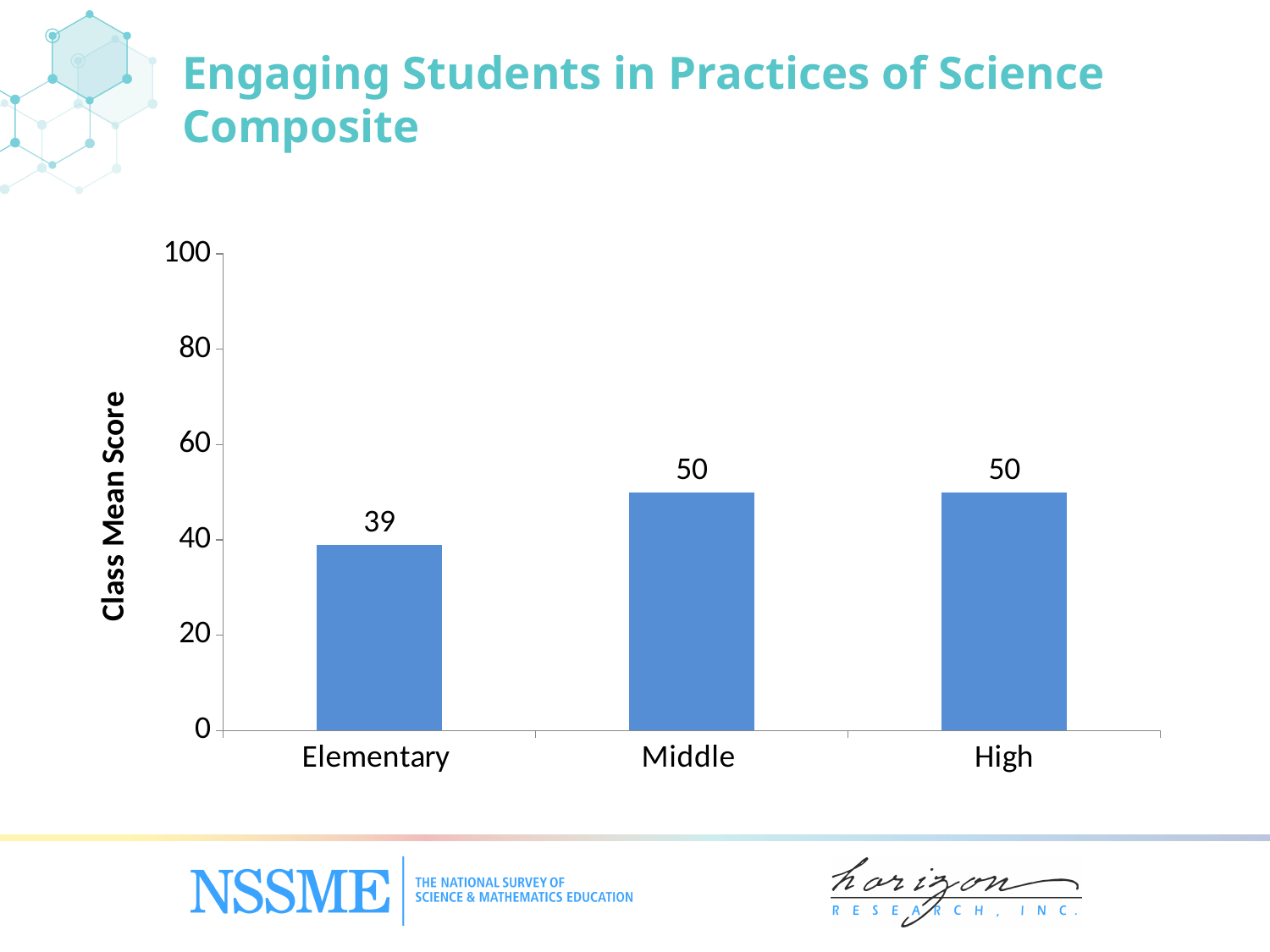
What is the label of the vertical axis? Class Mean Score Which has a higher class mean score, Elementary or High? High What is the class mean score for Elementary? 39 What is the difference between the class mean scores for Middle and Elementary? 11 What is the class mean score for Middle? 50 What is the maximum value shown on the vertical axis? 100 What kind of chart is shown on the slide? bar chart What is the class mean score for High? 50 Is the value for Elementary greater or less than 40? less Which grade level has the lowest class mean score? Elementary How many grade levels are shown on the chart? 3